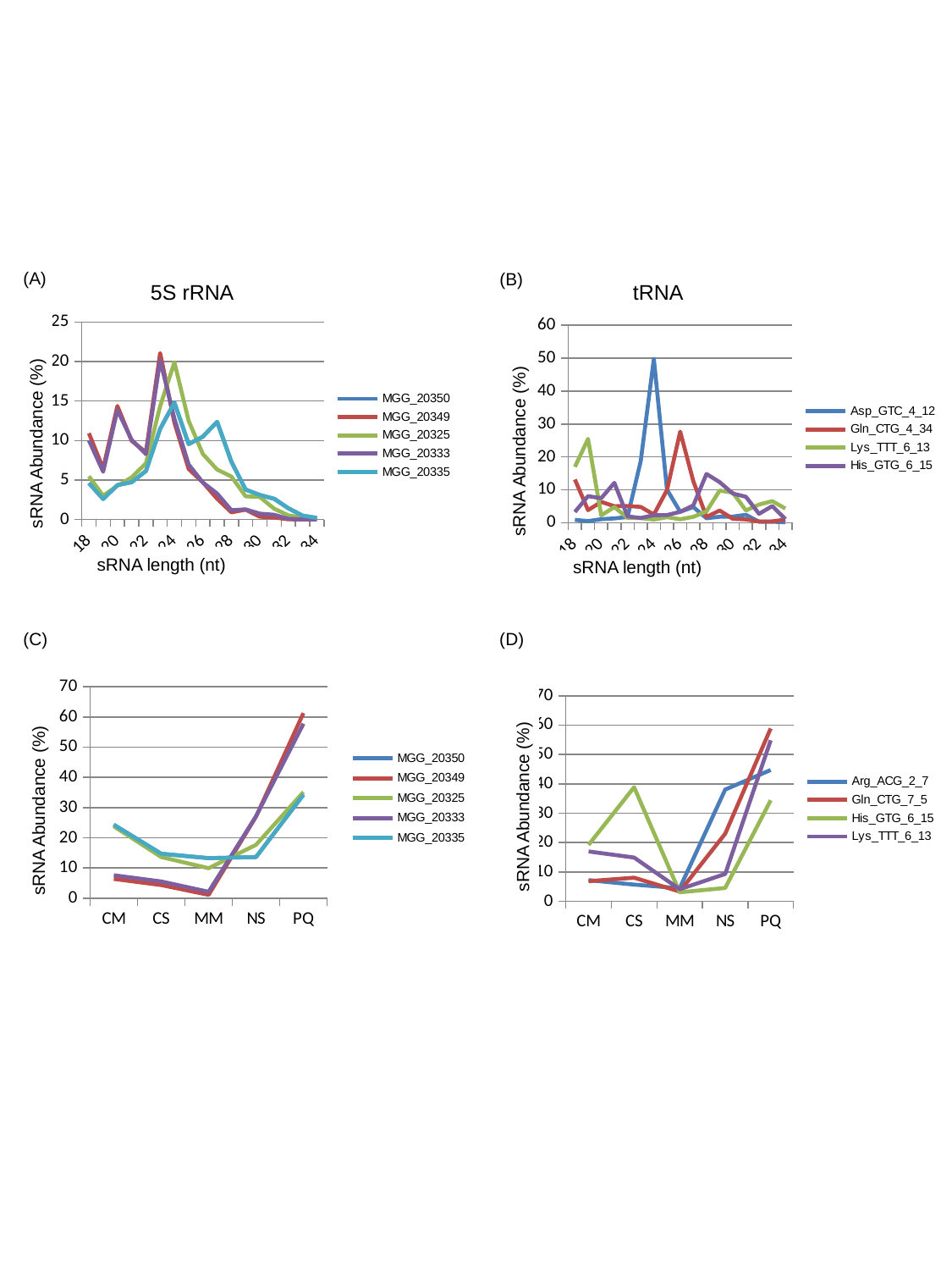
In chart (C), the bottom-left chart, which category has the lowest value for MGG_20349? MM In chart (C), the bottom-left chart, is the value for MGG_20349 at PQ greater or less than 50? greater In chart (D), the bottom-right chart, which is larger at NS: Arg_ACG_2_7 or Gln_CTG_7_5? Arg_ACG_2_7 What type of chart is chart (A), titled 5S rRNA? line chart How many series does the legend of chart (A), titled 5S rRNA, list? 5 How many categories are shown on the x axis of chart (C), the bottom-left chart? 5 In chart (D), the bottom-right chart, which series has the highest value at CS? His_GTG_6_15 In chart (A), titled 5S rRNA, is the value for MGG_20349 at sRNA length 23 greater or less than 15? greater In chart (B), titled tRNA, is the peak value for Asp_GTC_4_12 at sRNA length 24 greater or less than 40? greater How many series does the legend of chart (B), titled tRNA, list? 4 What is the x-axis label of chart (B), titled tRNA? sRNA length (nt) In chart (B), titled tRNA, which series reaches the highest sRNA abundance? Asp_GTC_4_12